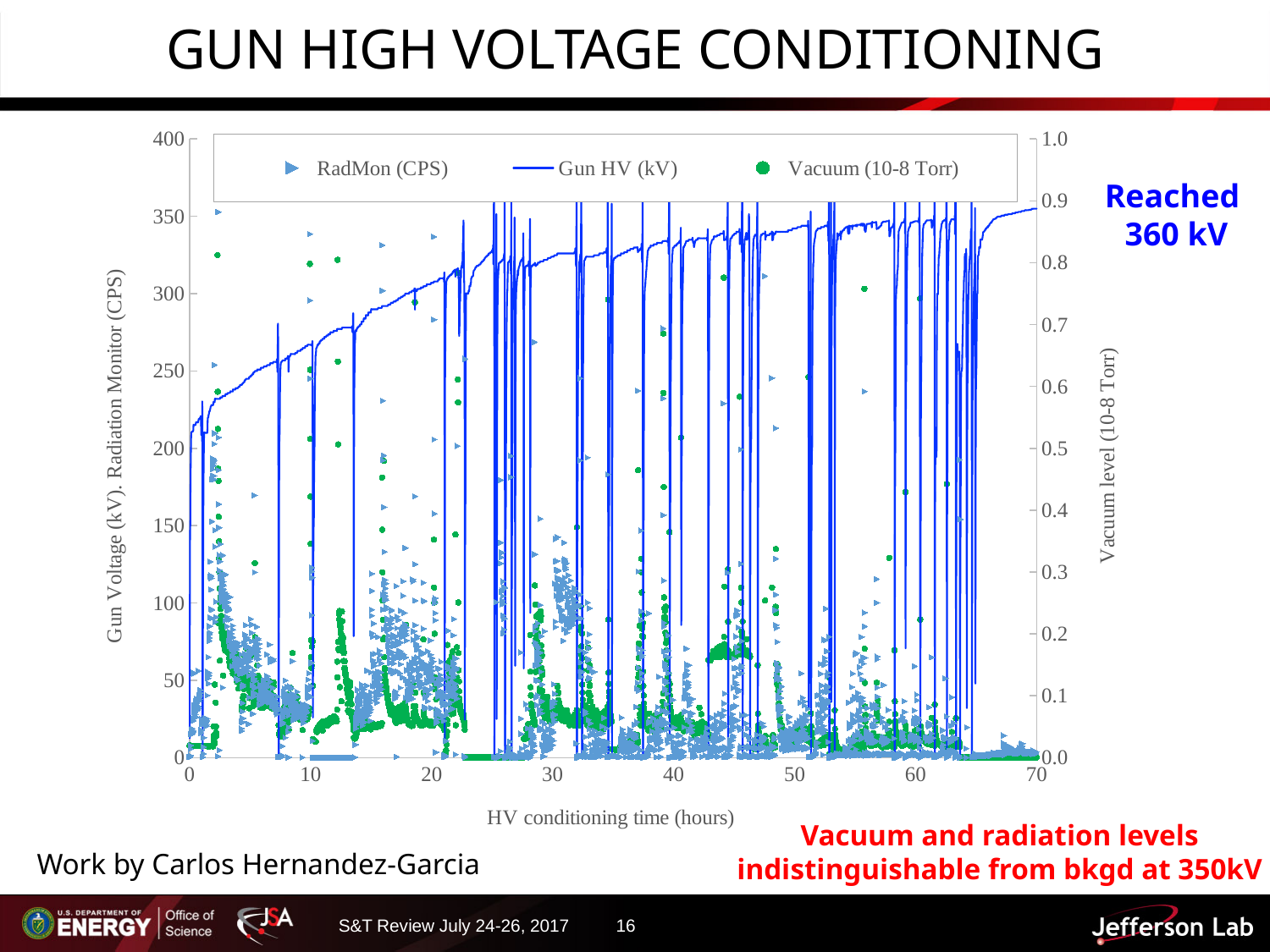
Does the Gun HV (kV) line generally rise or fall as HV conditioning time increases? rise What is the label of the left-hand y axis of the chart? Gun Voltage (kV). Radiation Monitor (CPS) What kind of chart is shown on the slide? line chart with scatter points Is the Gun HV (kV) value at 0 hours greater or less than 300? less What is the maximum value shown on the left-hand y axis of the chart? 400 Is the Gun HV (kV) value at 70 hours greater or less than 300? greater What is the maximum value shown on the x axis of the chart? 70 How many series does the chart legend list? 3 What are the three series named in the chart legend? RadMon (CPS), Gun HV (kV), Vacuum (10-8 Torr) What is the label of the x axis of the chart? HV conditioning time (hours) What colour are the Vacuum (10-8 Torr) markers in the chart? green What is the label of the right-hand y axis of the chart? Vacuum level (10-8 Torr)